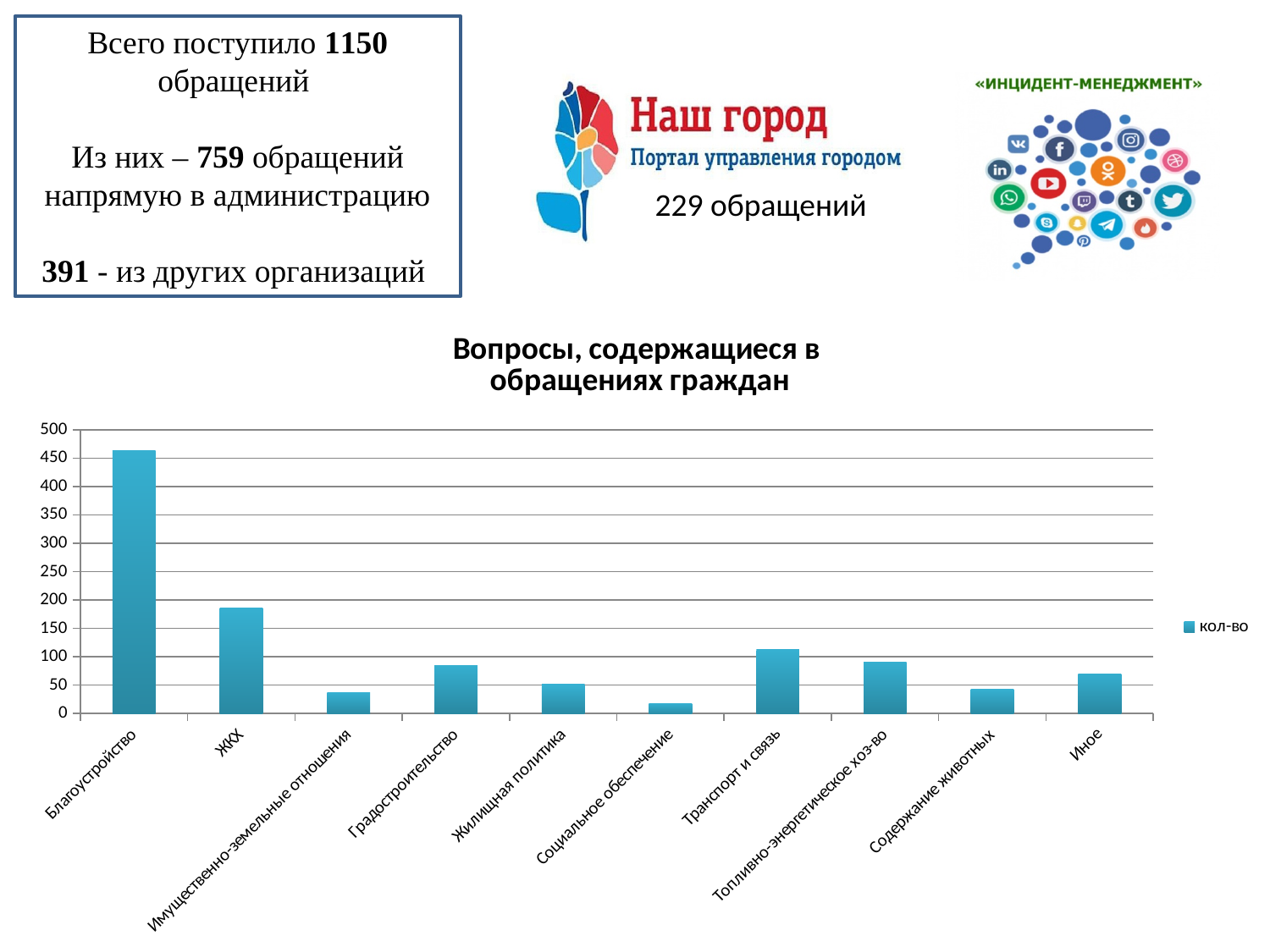
Is the value for Социальное обеспечение greater or less than 50? less Is the value for Благоустройство greater or less than 400? greater Is the value for ЖКХ greater or less than 200? less Which category has the lowest bar in the chart? Социальное обеспечение Which category has the highest bar in the chart? Благоустройство What is the name of the series shown in the chart legend? кол-во How many series does the chart legend list? 1 Which is larger, the value for ЖКХ or the value for Транспорт и связь? ЖКХ How many categories are plotted on the x axis of the chart? 10 Which is larger, the value for Градостроительство or the value for Жилищная политика? Градостроительство What kind of chart is shown under the title "Вопросы, содержащиеся в обращениях граждан"? bar chart